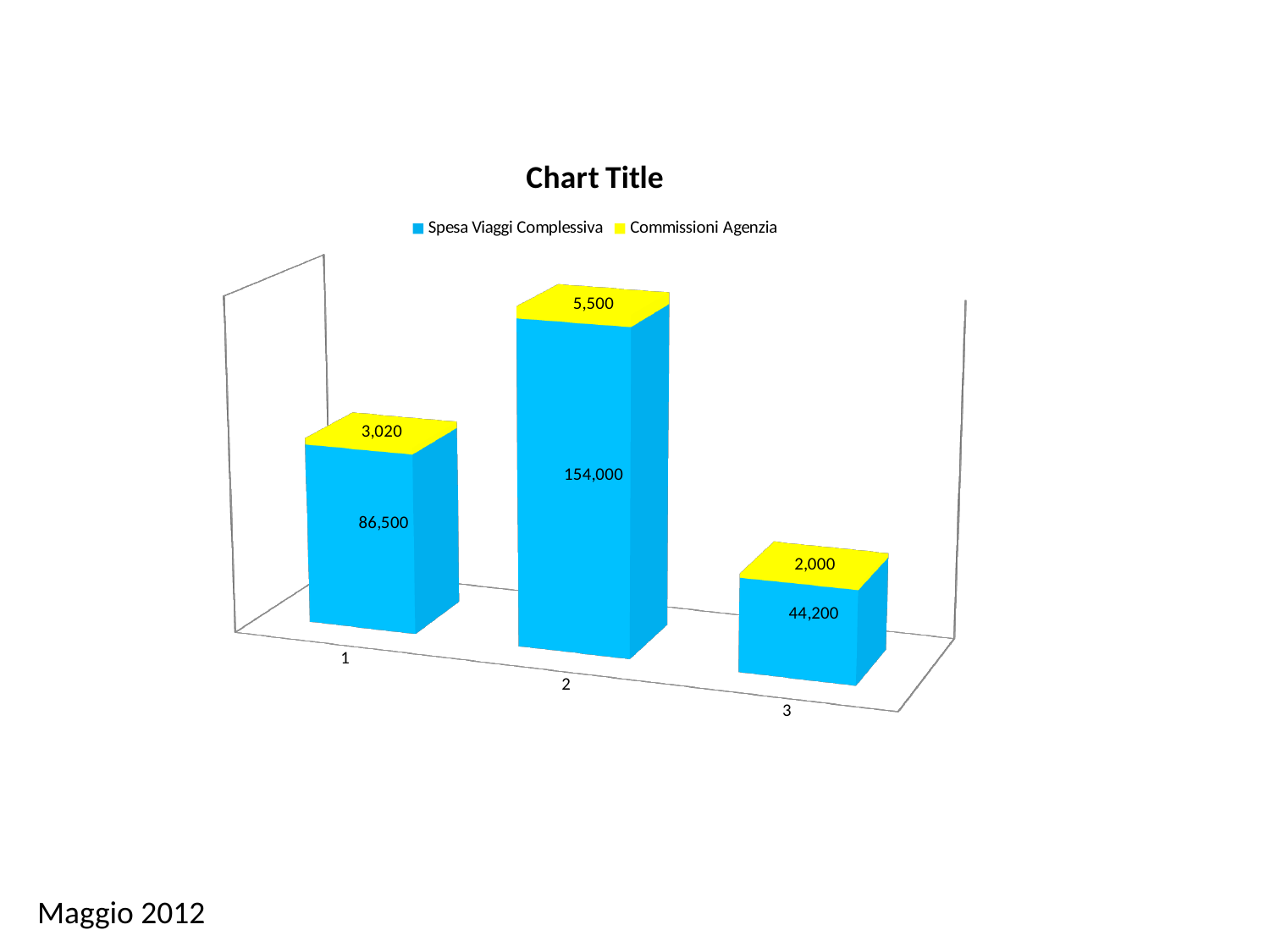
What is the total of the stacked bar for category 3? 46,200 What kind of chart is shown on the slide? stacked bar chart What is the value of Spesa Viaggi Complessiva for category 2? 154,000 What is the value of Spesa Viaggi Complessiva for category 3? 44,200 Is Commissioni Agenzia larger for category 1 or category 2? category 2 What is the difference between Spesa Viaggi Complessiva for category 2 and category 1? 67,500 How many series does the legend list? 2 How many categories are shown on the x axis? 3 Which category has the lowest Commissioni Agenzia? 3 What is the value of Commissioni Agenzia for category 3? 2,000 Which category has the highest Spesa Viaggi Complessiva? 2 What is the value of Commissioni Agenzia for category 1? 3,020